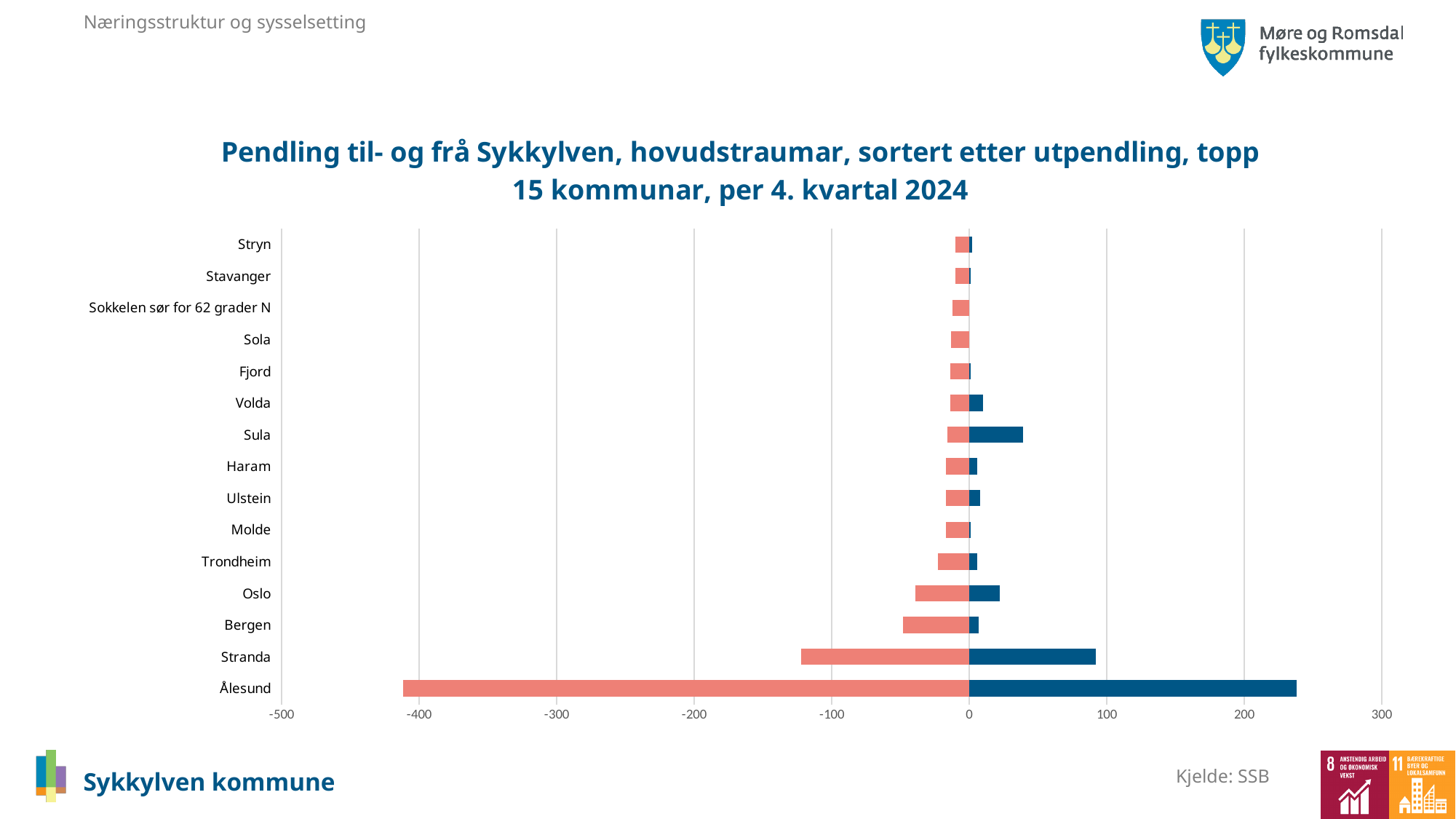
What is the source cited for the chart? SSB How many municipalities (categories) are listed on the chart? 15 Which has the longer red bar, Bergen or Trondheim? Bergen Which municipality has the longest red (negative) bar? Ålesund Is the blue bar value for Ålesund greater or less than 200? greater Which municipality has the longest blue (positive) bar? Ålesund Which has the longer blue bar, Stranda or Sula? Stranda Is the blue bar value for Stranda greater or less than 100? less Which municipality is listed at the top of the chart? Stryn Is the red bar value for Stranda greater or less than -100? less What kind of chart is shown on the slide? bar chart